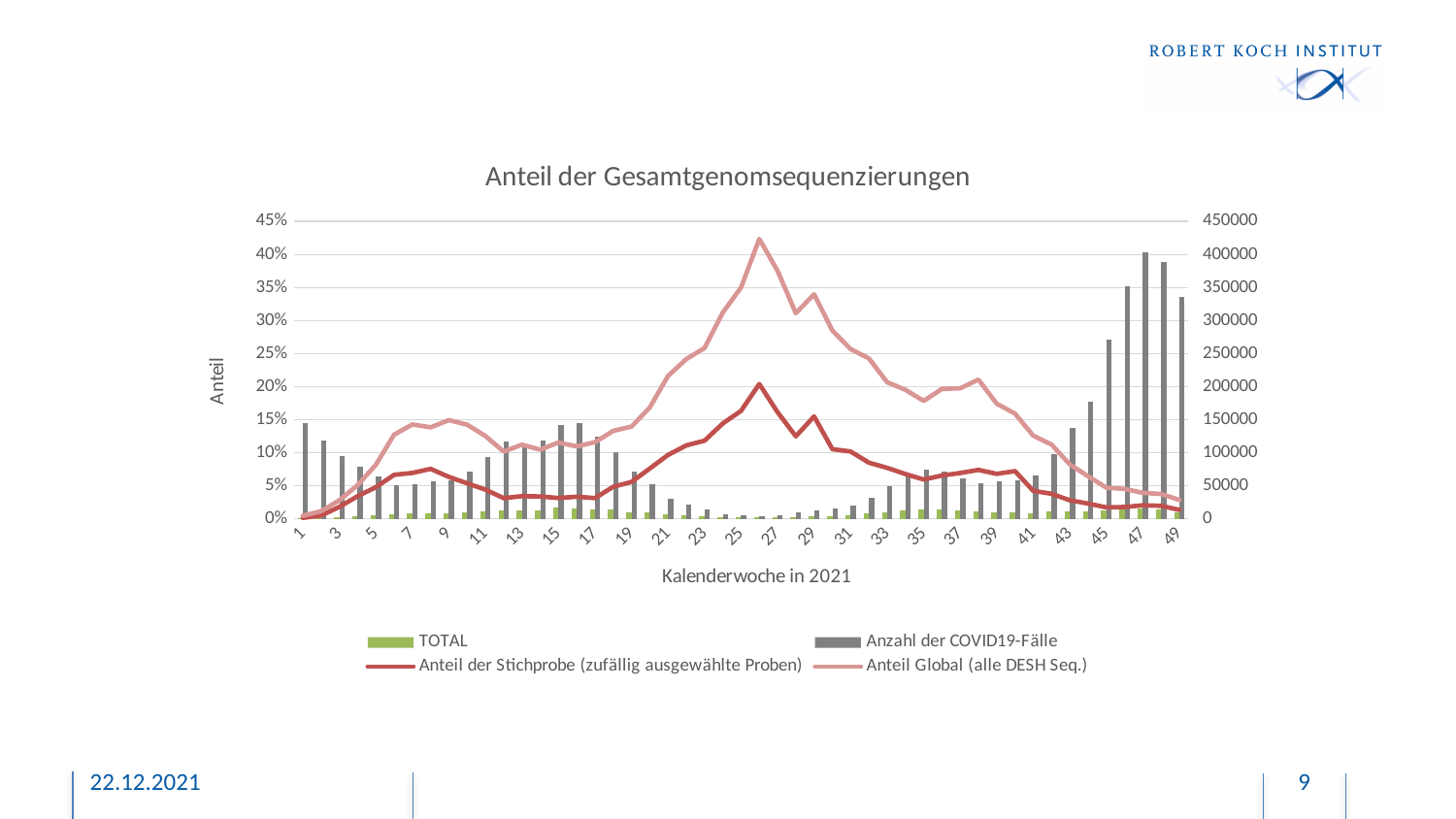
In which calendar week does the 'Anteil Global (alle DESH Seq.)' line reach its highest value? 26 Is the 'Anzahl der COVID19-Fälle' value in week 47 greater or less than 350000? greater In week 26, which is larger: 'Anteil Global (alle DESH Seq.)' or 'Anteil der Stichprobe (zufällig ausgewählte Proben)'? Anteil Global (alle DESH Seq.) Is the value of 'Anteil der Stichprobe (zufällig ausgewählte Proben)' in week 26 greater or less than 15%? greater In which calendar week is the 'Anzahl der COVID19-Fälle' bar the tallest? 47 Is the value of 'Anteil Global (alle DESH Seq.)' in week 26 greater or less than 40%? greater Does the 'Anteil Global (alle DESH Seq.)' line rise or fall from week 26 to week 49? fall How many series does the legend list? 4 What is the title of the chart? Anteil der Gesamtgenomsequenzierungen In which calendar week does the 'Anteil der Stichprobe (zufällig ausgewählte Proben)' line reach its highest value? 26 What kind of chart is this? A combined bar and line chart What is the label of the x axis? Kalenderwoche in 2021